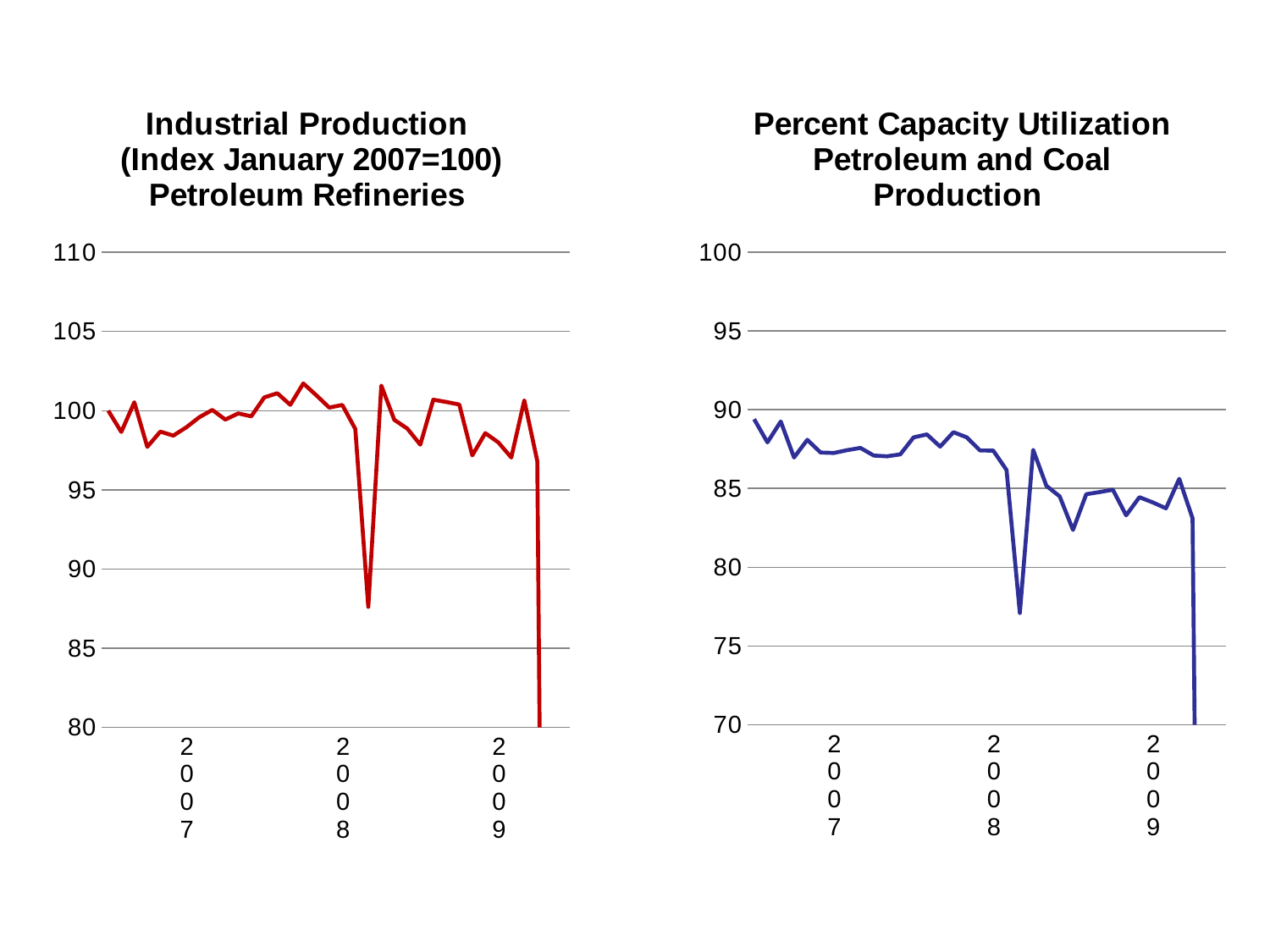
What kind of chart is the Percent Capacity Utilization chart on the right? line chart What colour is the line in the Industrial Production chart on the left? red In the Industrial Production chart on the left, what is the index value at the first point, January 2007? 100 In the Percent Capacity Utilization chart on the right, is the first value at the start of 2007 greater or less than 90? less What is the title of the chart on the right? Percent Capacity Utilization Petroleum and Coal Production What kind of chart is the Industrial Production chart on the left? line chart In the Industrial Production chart on the left, is the lowest point of the line during 2008 greater or less than 90? less In the Percent Capacity Utilization chart on the right, are the values in 2009 greater or less than 90? less In the Percent Capacity Utilization chart on the right, do the values generally rise or fall from 2007 to 2009? fall How many year labels are shown on the x axis of the Industrial Production chart on the left? 3